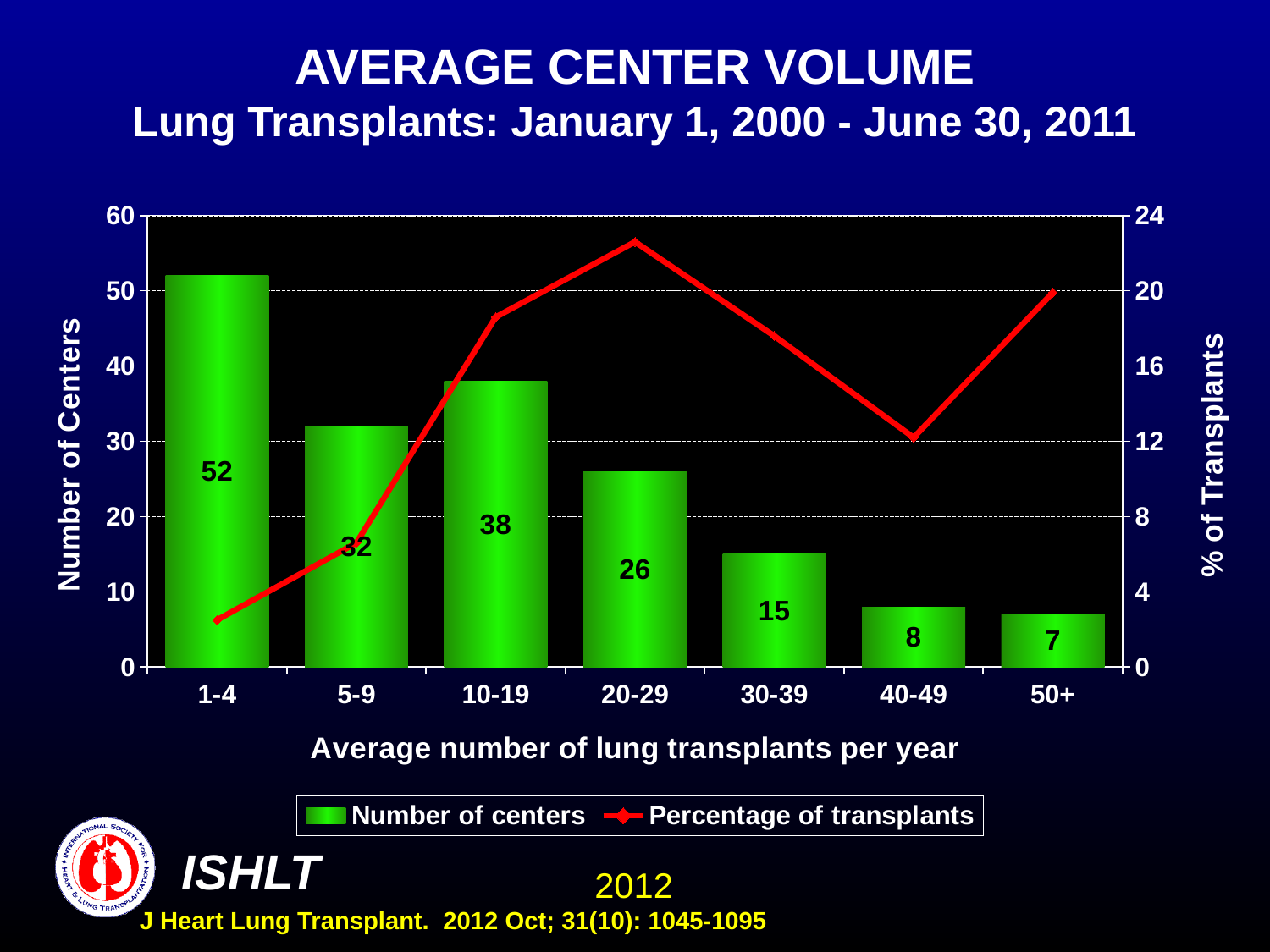
How many categories are shown on the x axis? 7 Does the number of centers rise or fall as the average number of lung transplants per year increases? fall Is the percentage of transplants for the 20-29 category greater or less than 20? greater Which category has the highest number of centers? 1-4 Which has more centers, the 5-9 category or the 40-49 category? 5-9 How many centers are in the 20-29 category? 26 How many series does the legend list? 2 Which category has the lowest number of centers? 50+ How many centers are in the 50+ category? 7 How many centers are in the 1-4 average lung transplants per year category? 52 Is the percentage of transplants for the 1-4 category greater or less than 4? less What is the difference in number of centers between the 10-19 and 30-39 categories? 23